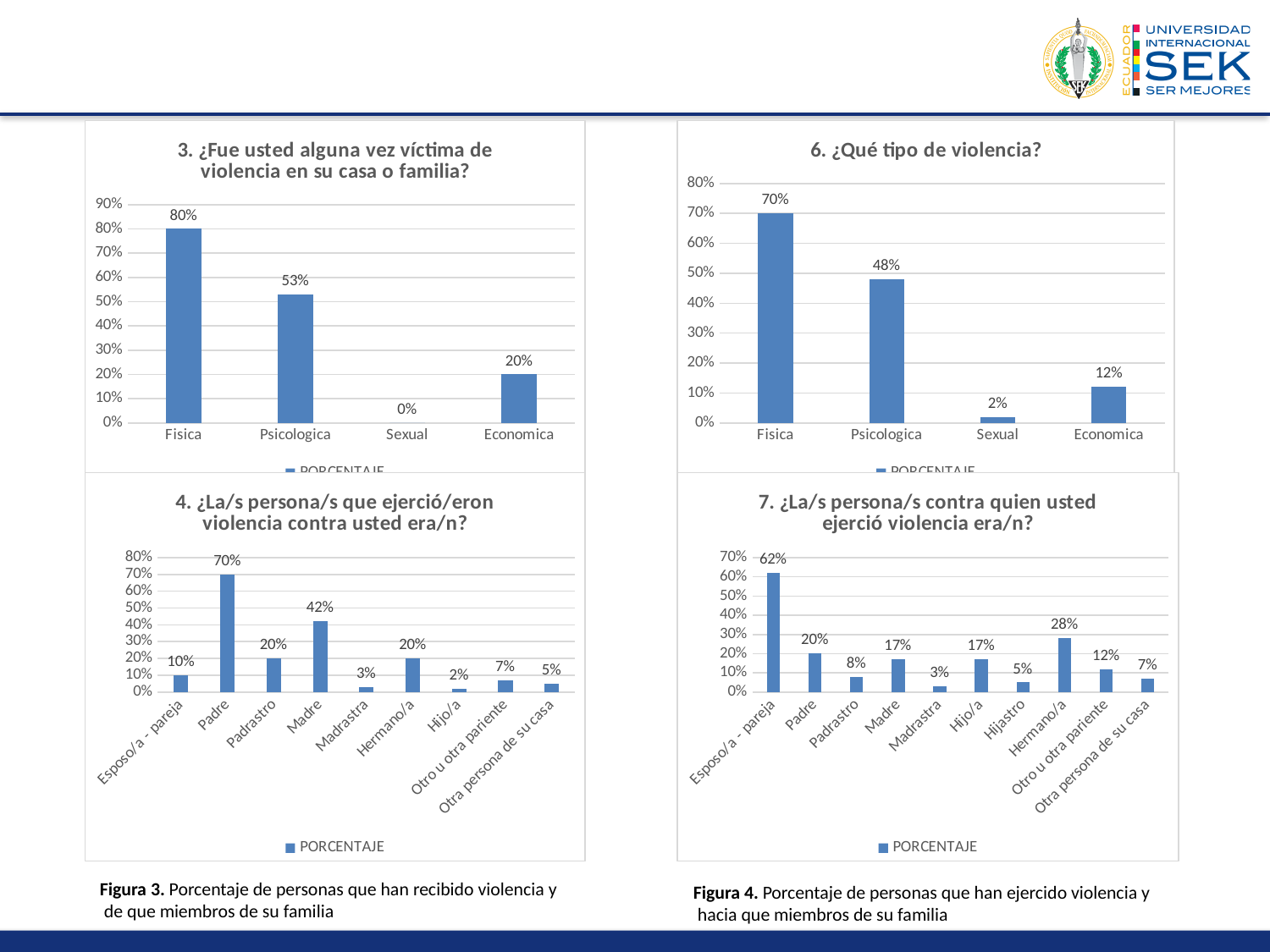
In the chart titled "3. ¿Fue usted alguna vez víctima de violencia en su casa o familia?", what is the difference between the values for Fisica and Economica? 60% In the chart titled "6. ¿Qué tipo de violencia?", what is the difference between the values for Fisica and Psicologica? 22% What type of chart is the chart titled "7. ¿La/s persona/s contra quien usted ejerció violencia era/n?"? Bar chart In the chart titled "4. ¿La/s persona/s que ejerció/eron violencia contra usted era/n?", which is larger, the value for Padrastro or the value for Esposo/a - pareja? Padrastro In the chart titled "7. ¿La/s persona/s contra quien usted ejerció violencia era/n?", which category has the highest value? Esposo/a - pareja In the chart titled "6. ¿Qué tipo de violencia?", what is the value for Economica? 12% In the chart titled "7. ¿La/s persona/s contra quien usted ejerció violencia era/n?", what is the value for Hermano/a? 28% In the chart titled "4. ¿La/s persona/s que ejerció/eron violencia contra usted era/n?", how many categories are shown on the x axis? 9 In the chart titled "3. ¿Fue usted alguna vez víctima de violencia en su casa o familia?", what is the value for Psicologica? 53% In the chart titled "4. ¿La/s persona/s que ejerció/eron violencia contra usted era/n?", what is the value for Madre? 42% In the chart titled "3. ¿Fue usted alguna vez víctima de violencia en su casa o familia?", which category has the highest value? Fisica In the chart titled "6. ¿Qué tipo de violencia?", which category has the lowest value? Sexual